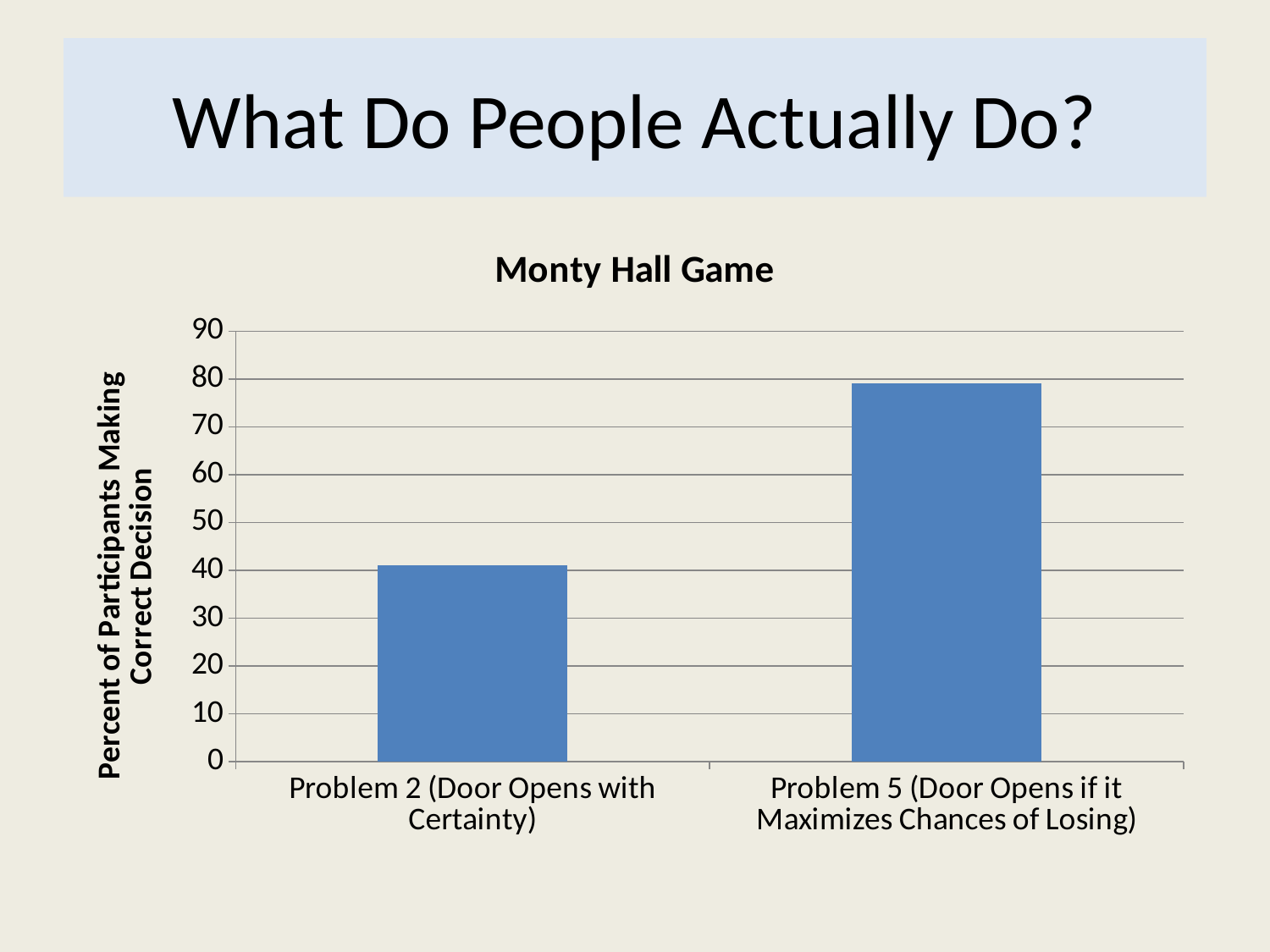
Is the value for Problem 2 (Door Opens with Certainty) greater or less than 50? less Which category has the lowest value? Problem 2 (Door Opens with Certainty) Which is larger, the value for Problem 2 (Door Opens with Certainty) or the value for Problem 5 (Door Opens if it Maximizes Chances of Losing)? Problem 5 (Door Opens if it Maximizes Chances of Losing) Which category has the highest value? Problem 5 (Door Opens if it Maximizes Chances of Losing) What is the title of the chart? Monty Hall Game What is the label of the vertical axis? Percent of Participants Making Correct Decision How many categories are plotted in the chart? 2 Is the value for Problem 5 (Door Opens if it Maximizes Chances of Losing) greater or less than 70? greater Do the values rise or fall from left to right along the x axis? rise Is the value for Problem 2 (Door Opens with Certainty) greater or less than 30? greater What type of chart is shown on the slide? bar chart